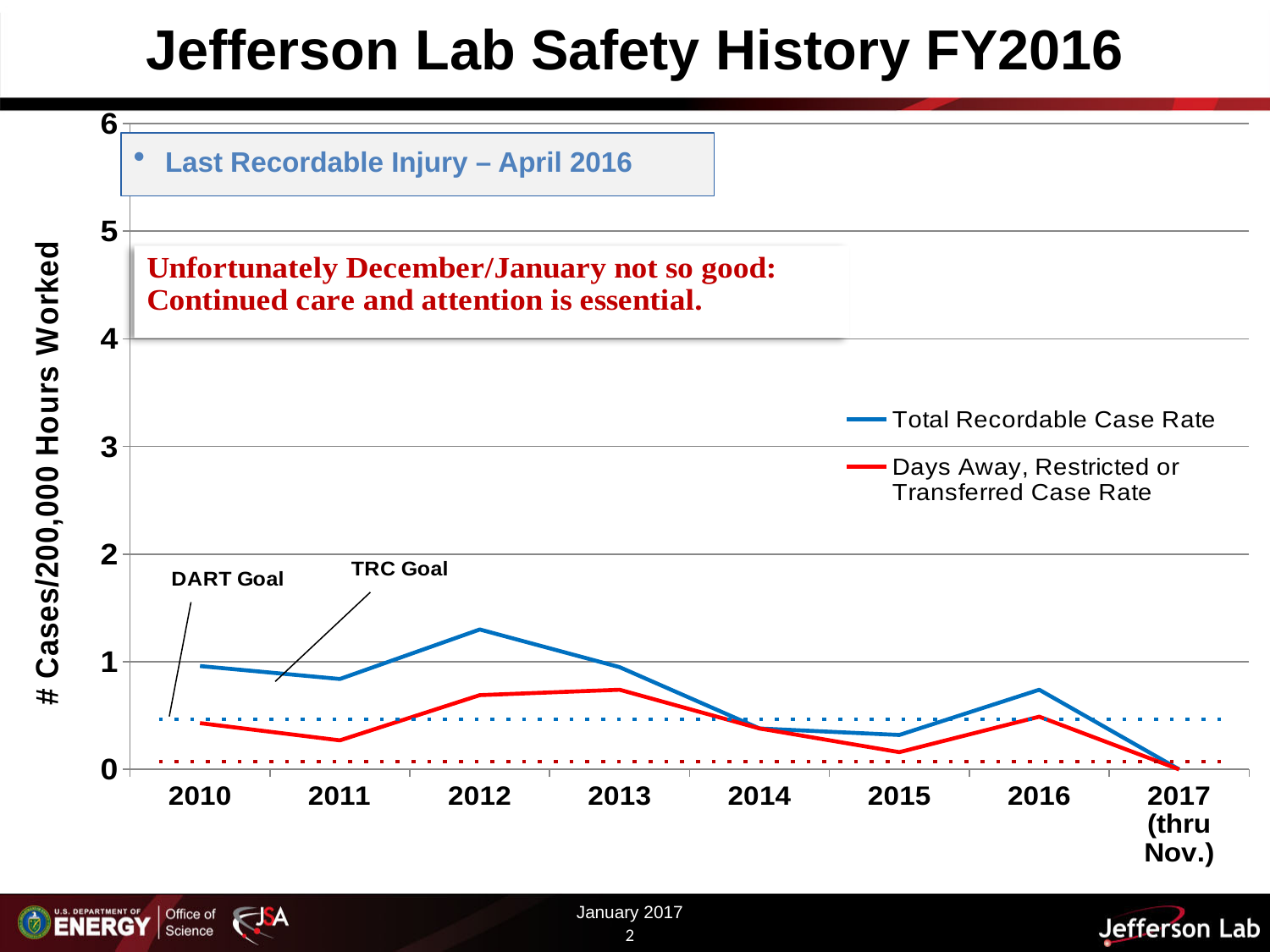
In 2012, which is larger: the Total Recordable Case Rate or the Days Away, Restricted or Transferred Case Rate? Total Recordable Case Rate Is the Days Away, Restricted or Transferred Case Rate for 2013 greater or less than 1? less What kind of chart is shown on the slide? Line chart How many series does the legend list? 2 Is the Total Recordable Case Rate for 2014 greater or less than 1? less Does the Total Recordable Case Rate rise or fall from 2016 to 2017 (thru Nov.)? Fall Is the Total Recordable Case Rate for 2012 greater or less than 1? greater In which year is the Days Away, Restricted or Transferred Case Rate highest? 2013 How many years are plotted along the x axis? 8 In which year is the Total Recordable Case Rate highest? 2012 In which year is the Total Recordable Case Rate lowest? 2017 (thru Nov.) What is the title of the chart on the slide? Jefferson Lab Safety History FY2016